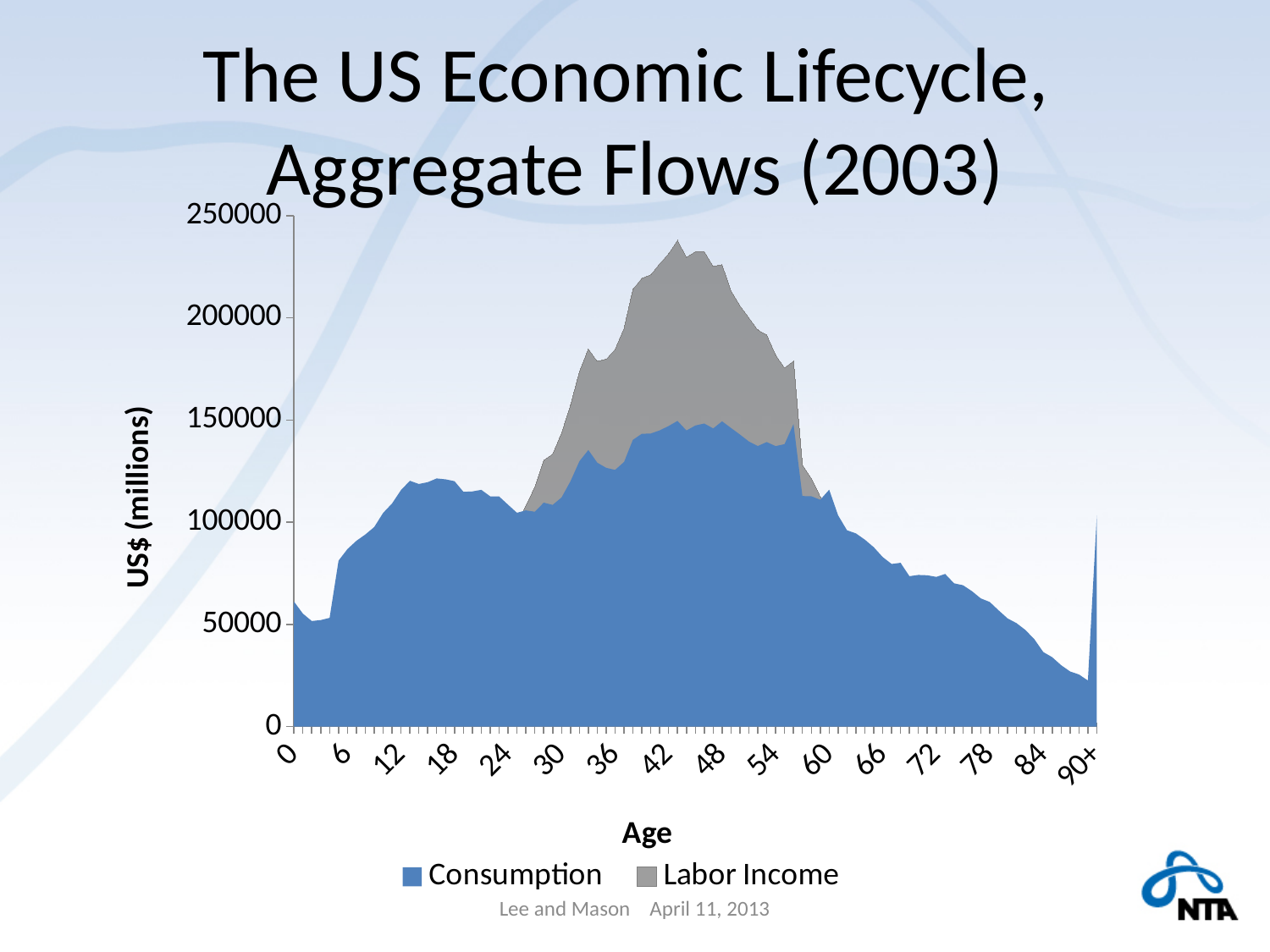
What is the highest value shown on the vertical axis? 250000 Is the Consumption value at age 66 greater or less than 100000? less Is the Consumption value at age 84 greater or less than 50000? less What is the label on the vertical axis? US$ (millions) Is the Consumption value at age 12 greater or less than 100000? greater How many series does the legend list? 2 What are the two series named in the legend? Consumption and Labor Income Does Consumption rise or fall between age 60 and age 84? fall What kind of chart is shown on the slide? Area chart Does Consumption rise or fall between age 0 and age 12? rise